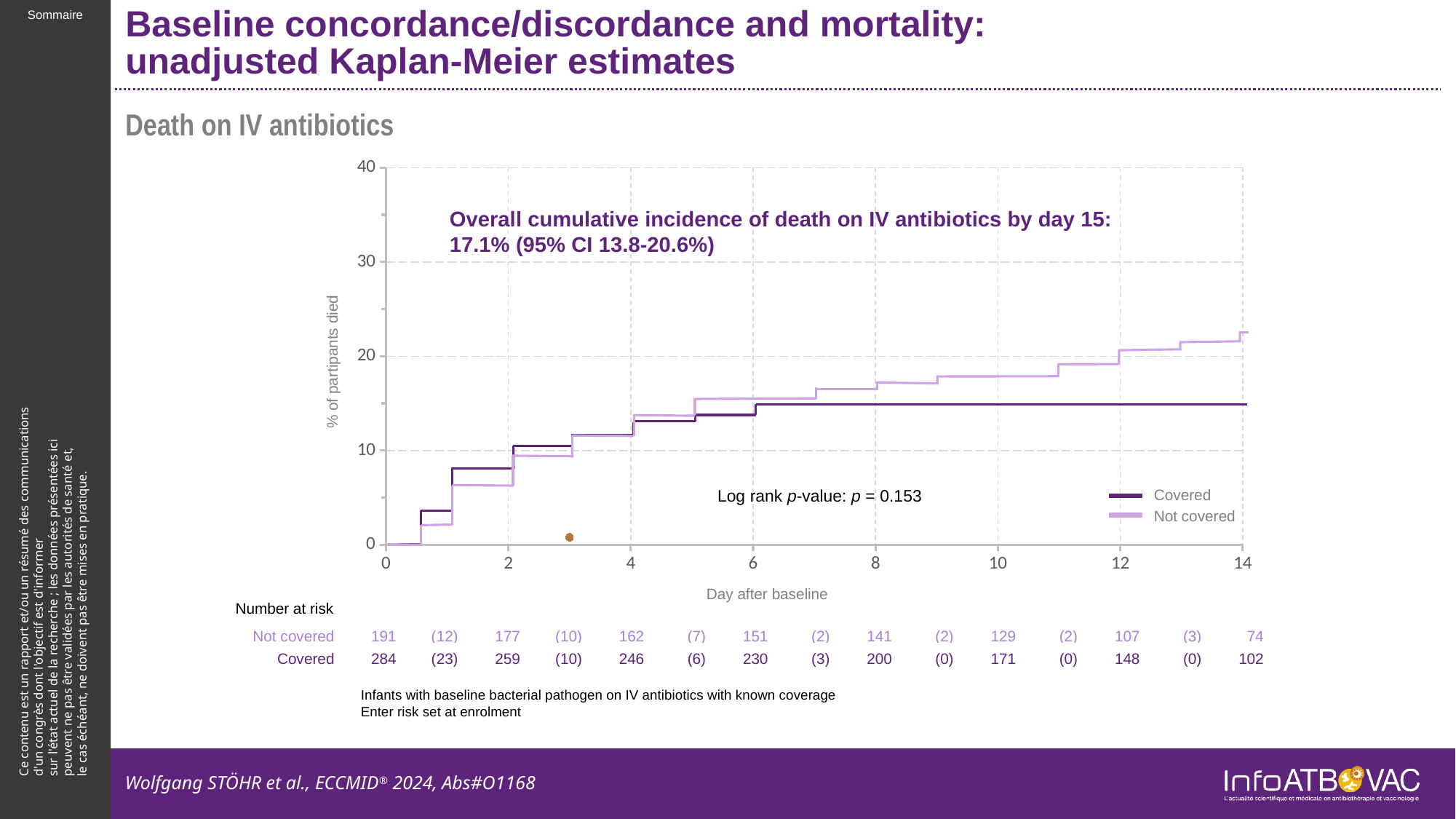
What log rank p-value is printed on the chart? p = 0.153 What are the two series named in the legend? Covered and Not covered Is the value for Covered at day 14 greater or less than 20? less What is the label of the y axis? % of partipants died What is the difference between the number at risk at day 0 for Covered (284) and Not covered (191)? 93 Is the value for Not covered at day 14 greater or less than 20? greater At day 14, which series has the higher percentage of participants died, Covered or Not covered? Not covered What is the number at risk for the Covered group at day 14? 102 How many series does the legend list? 2 Do the curves rise or fall as the day after baseline increases? rise What is the number at risk for the Not covered group at day 0? 191 What kind of chart is shown on the slide? Line chart (Kaplan-Meier step curves)